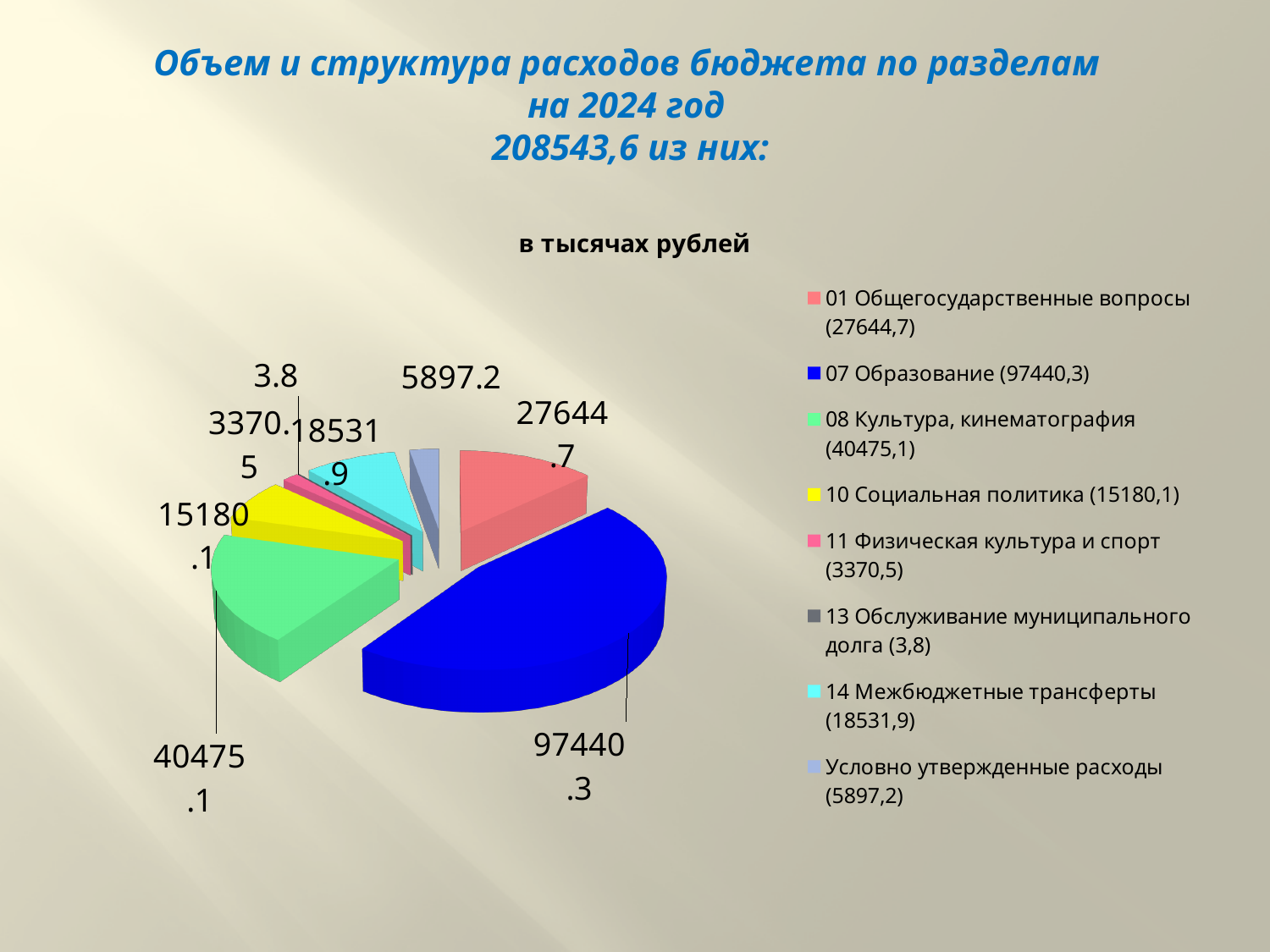
What is the value for 13 Обслуживание муниципального долга? 3.8 What is the difference between the values for 07 Образование and 08 Культура, кинематография? 56965.2 What kind of chart is shown on the slide? pie chart What is the difference between the values for 01 Общегосударственные вопросы and 10 Социальная политика? 12464.6 Which category has the smallest slice of the pie? 13 Обслуживание муниципального долга Which category has the largest slice of the pie? 07 Образование What is the value for 14 Межбюджетные трансферты? 18531.9 What is the title of the chart? в тысячах рублей What is the value for 07 Образование? 97440.3 What is the value for 08 Культура, кинематография? 40475.1 How many categories does the legend list? 8 Which is larger: 01 Общегосударственные вопросы or 10 Социальная политика? 01 Общегосударственные вопросы